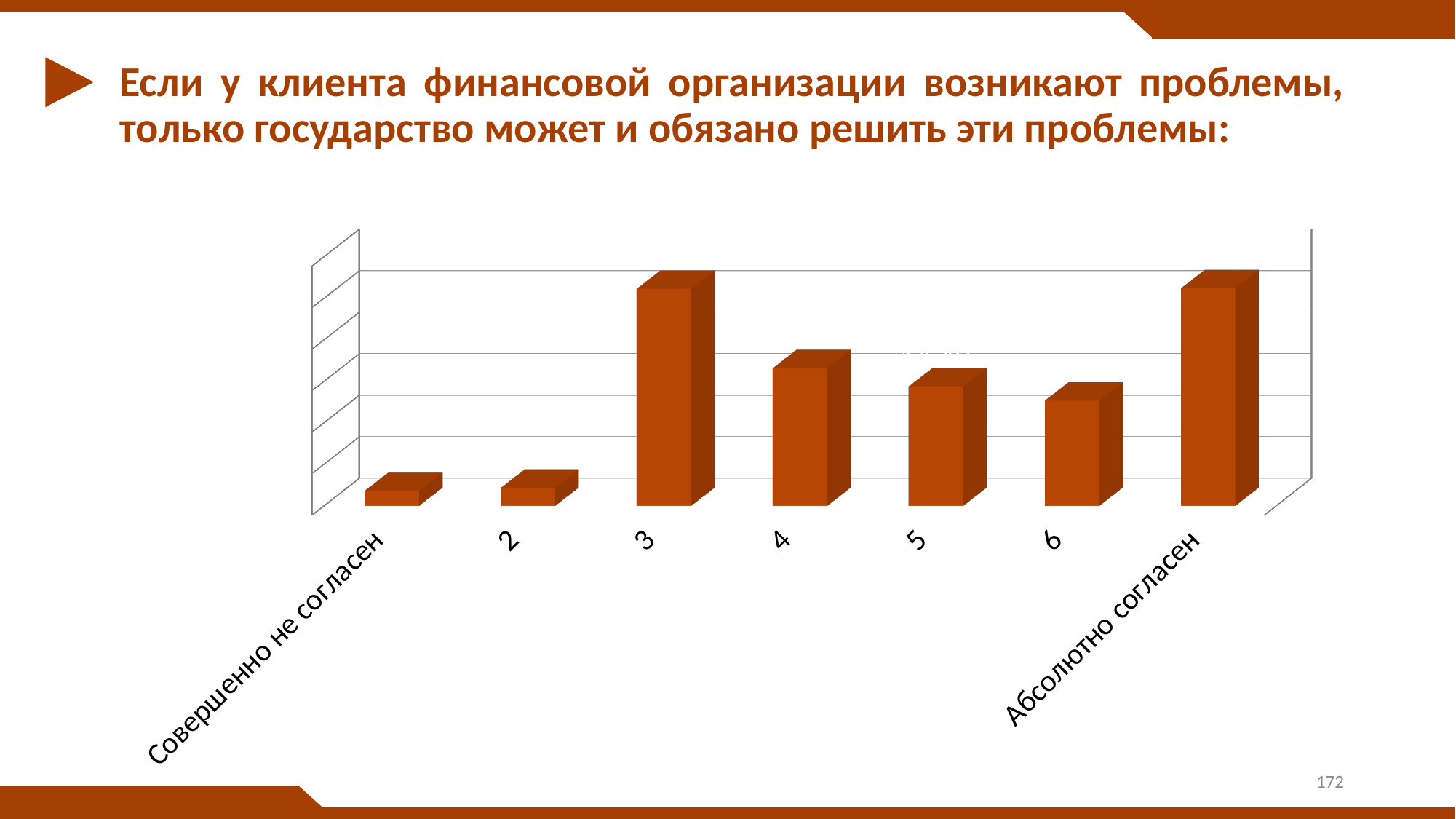
Which is larger, the value for category 5 or the value for category 6? 5 Do the values rise or fall going from category 6 to "Абсолютно согласен"? rise What colour are the bars in the chart? orange-brown How many categories (bars) are shown on the chart? 7 Which is larger, the value for category 2 or the value for category 3? 3 Do the values rise or fall going from category 4 to category 6? fall What is the label of the first (leftmost) category on the x axis? Совершенно не согласен Which is larger, the value for "Совершенно не согласен" or the value for "Абсолютно согласен"? Абсолютно согласен What kind of chart is shown on the slide? bar chart